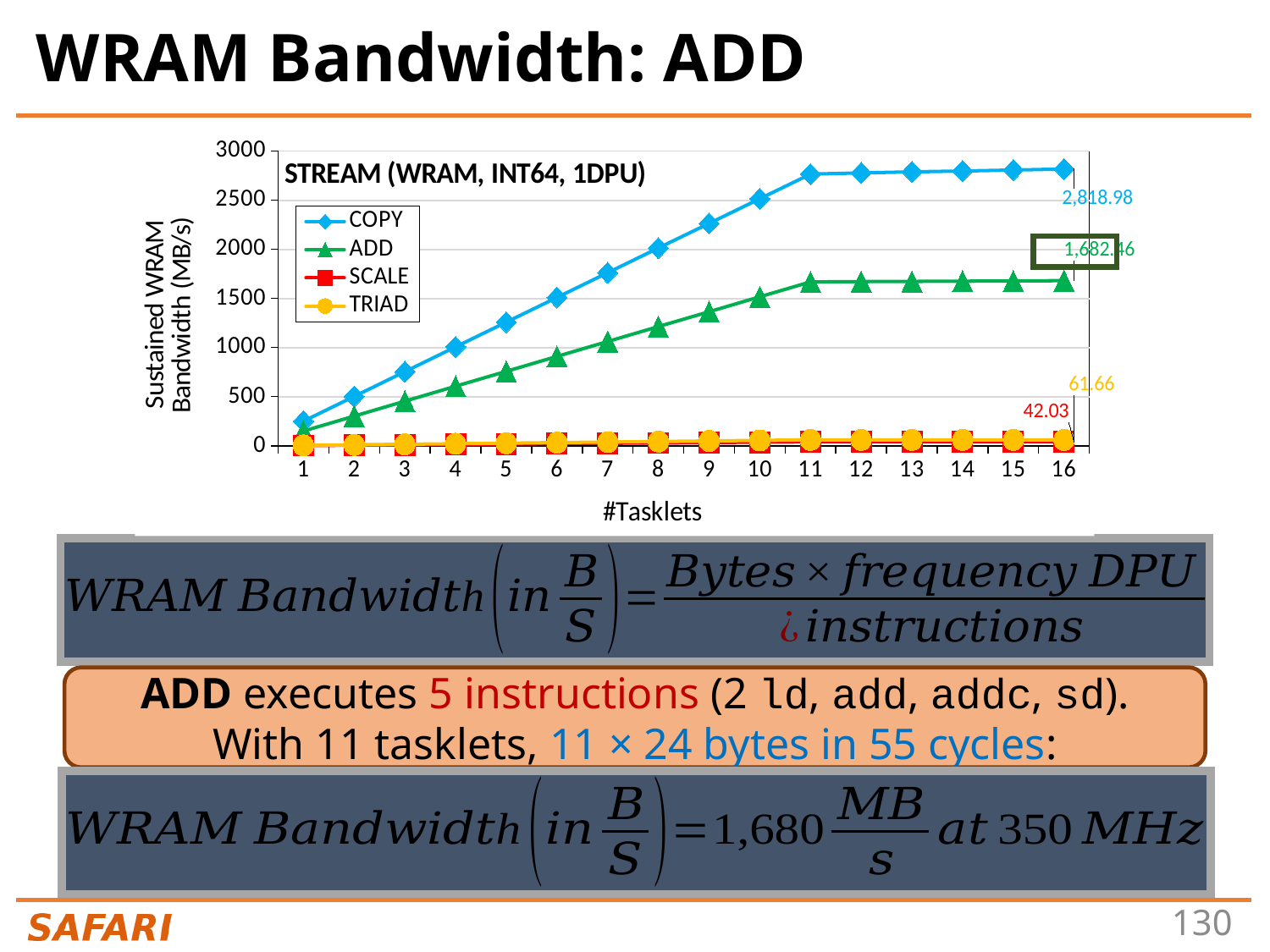
What is the labelled TRIAD bandwidth at 16 tasklets? 61.66 What is the difference between the TRIAD and SCALE labelled values at 16 tasklets? 19.63 What is the labelled SCALE bandwidth at 16 tasklets? 42.03 Is the COPY value at 5 tasklets greater or less than 1000? greater Does the ADD bandwidth rise or fall as #Tasklets increases from 1 to 11? rise At 16 tasklets, which is larger: COPY or ADD? COPY What is the labelled COPY bandwidth at 16 tasklets? 2,818.98 How many #Tasklets values are plotted along the x axis? 16 What kind of chart is shown on the slide? line chart How many series does the chart legend list? 4 Which series has the lowest bandwidth at 16 tasklets? SCALE Which series has the highest bandwidth at 16 tasklets? COPY